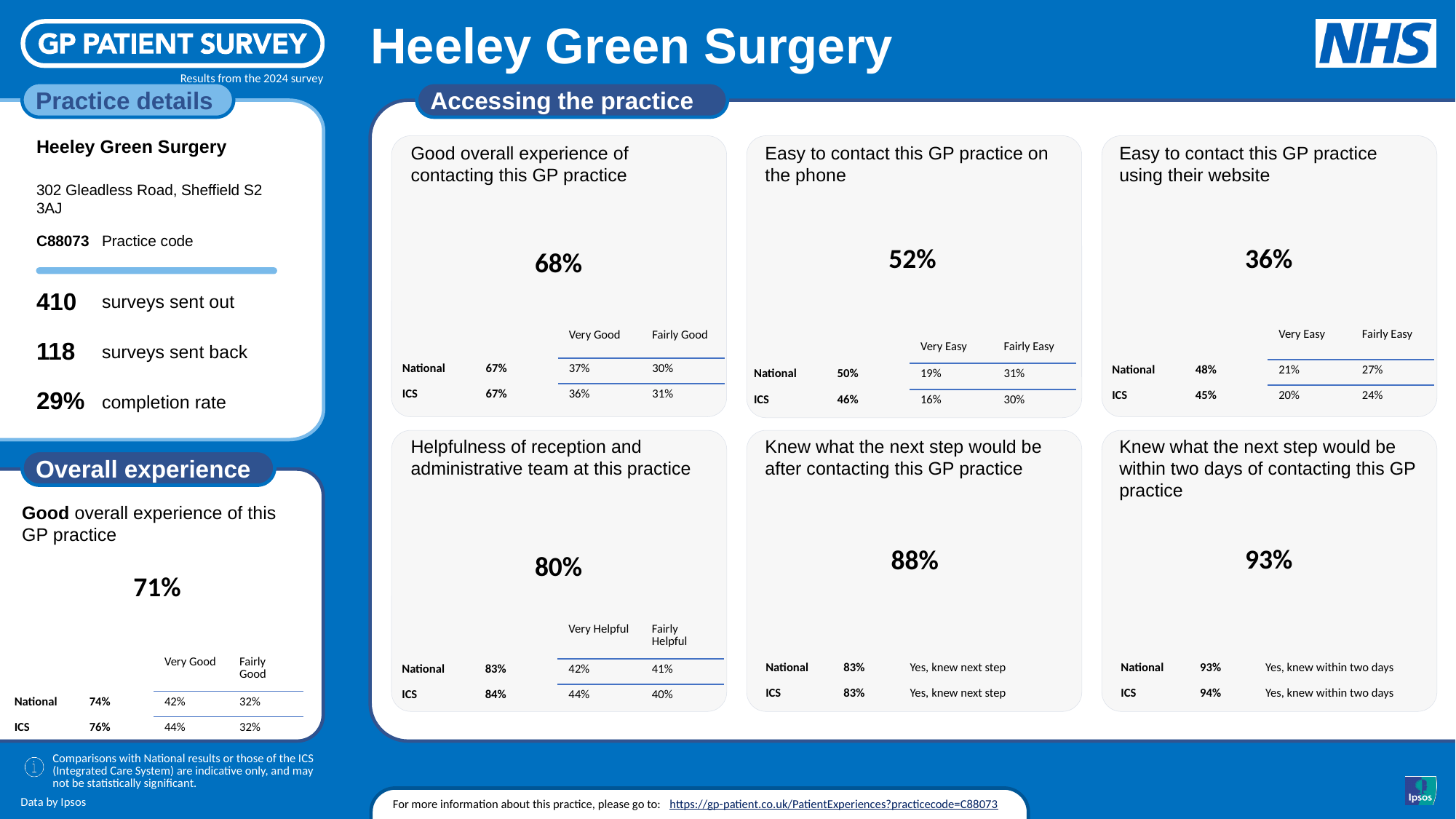
In the 'Good overall experience of contacting this GP practice' panel, what is the practice's headline value? 68% In the 'Knew what the next step would be after contacting this GP practice' panel, what is the difference between the practice's headline value and the ICS value? 5% In the 'Good overall experience of this GP practice' panel, what is the National value for Fairly Good? 32% Across the six 'Accessing the practice' panels, which has the highest practice headline value? Knew what the next step would be within two days of contacting this GP practice In the 'Knew what the next step would be within two days of contacting this GP practice' panel, what is the practice's headline value? 93% In the 'Easy to contact this GP practice using their website' panel, what is the difference between the National value and the practice's headline value? 12% In the 'Easy to contact this GP practice on the phone' panel, what is the practice's headline value? 52% In the 'Helpfulness of reception and administrative team at this practice' panel, what is the ICS value for Very Helpful? 44% How many panels are shown under the 'Accessing the practice' heading? 6 In the 'Easy to contact this GP practice using their website' panel, what is the National value? 48% Across the six 'Accessing the practice' panels, which has the lowest practice headline value? Easy to contact this GP practice using their website In the 'Easy to contact this GP practice on the phone' panel, is the practice value or the National value larger? practice